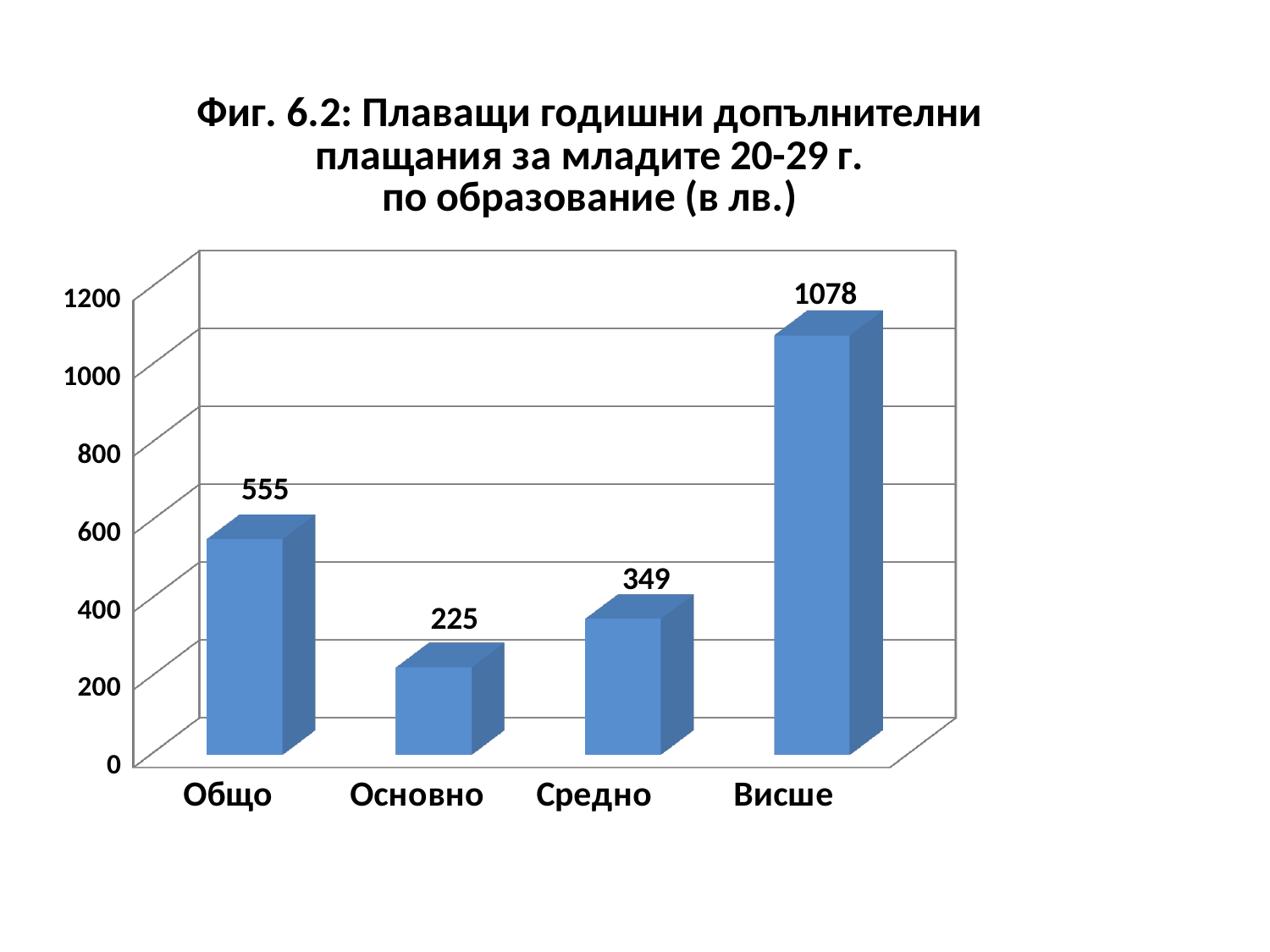
Is the value for Висше greater or less than 1000? greater Which is larger, the value for Средно or the value for Общо? Общо What is the value for Висше? 1078 What is the value for Средно? 349 What kind of chart is shown on the slide? bar chart How many categories are shown on the x axis? 4 What is the difference between the values for Висше and Основно? 853 Which category has the lowest value? Основно What is the value for Основно? 225 What is the difference between the values for Общо and Средно? 206 What is the value for Общо? 555 Which category has the highest value? Висше